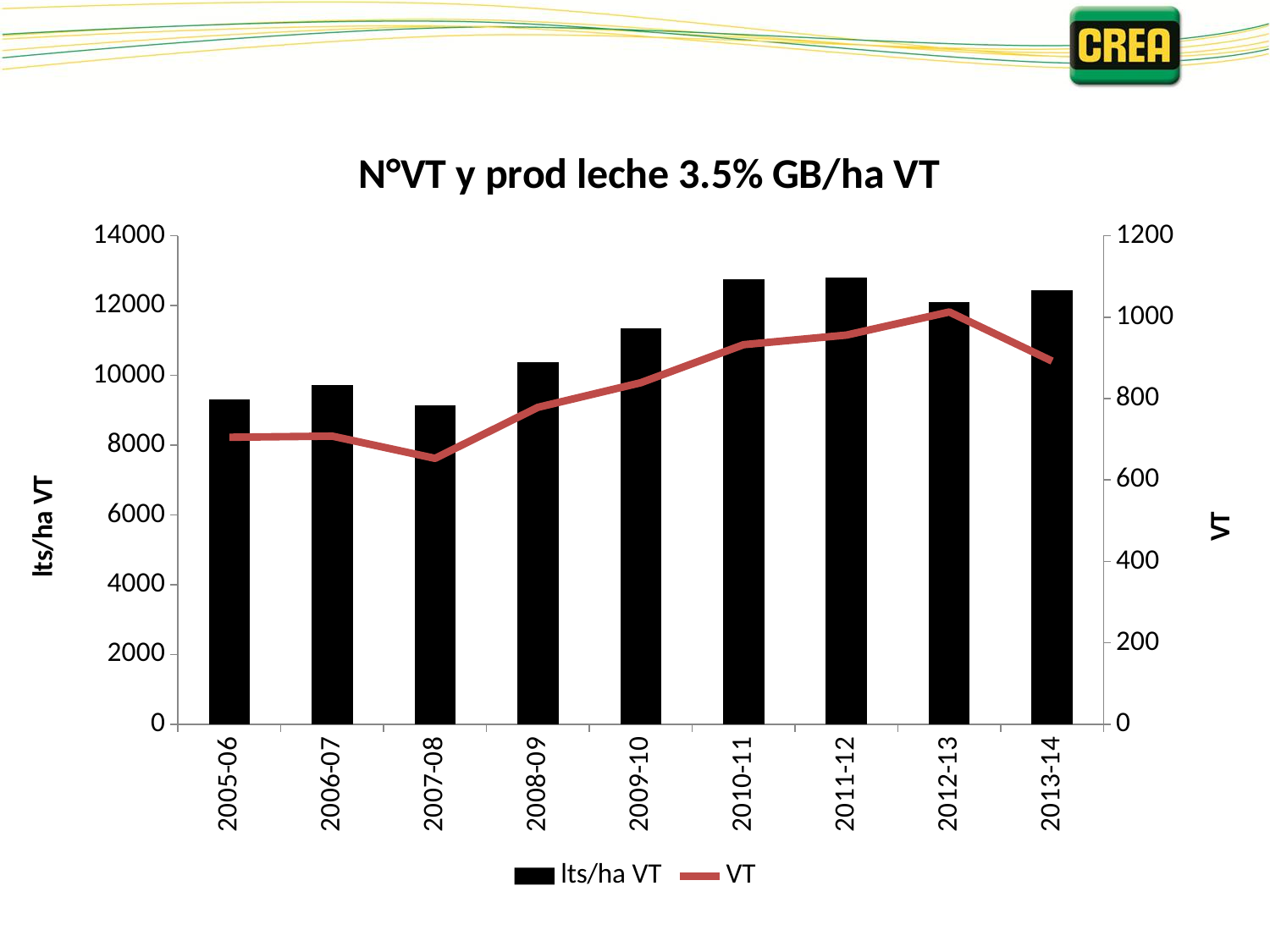
How many series does the legend list? 2 Does the VT line rise or fall from 2007-08 to 2012-13? rise Is the VT value for 2013-14 greater or less than 1000? less Is the lts/ha VT bar for 2005-06 greater or less than 10000? less Which period has the lowest VT value on the line? 2007-08 Which has the larger lts/ha VT bar, 2008-09 or 2009-10? 2009-10 Is the lts/ha VT bar for 2010-11 greater or less than 12000? greater How many periods are shown on the x axis? 9 Which period has the highest VT value on the line? 2012-13 What kind of chart is shown on the slide? A combined bar and line chart What is the title of the chart? N°VT y prod leche 3.5% GB/ha VT